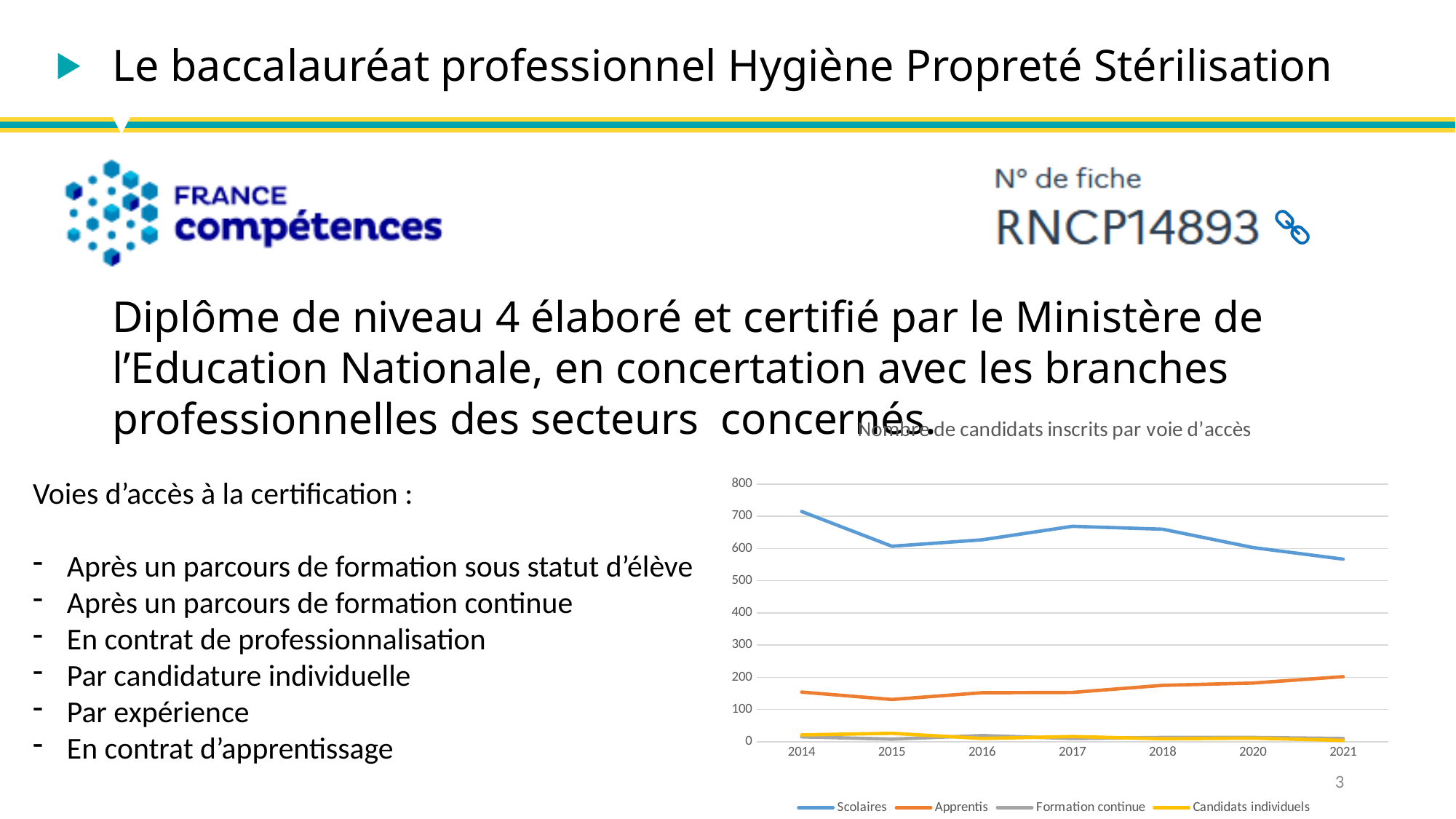
Which series has the highest values across all years in the chart? Scolaires What kind of chart is shown on the slide? line chart What colour is the Apprentis line in the chart? orange Does the Scolaires series rise or fall overall from 2014 to 2021? fall Is the value for Apprentis in 2021 greater or less than 150? greater In which year is the Scolaires series at its highest? 2014 Does the Apprentis series rise or fall overall from 2014 to 2021? rise How many series does the chart legend list? 4 Is the value for Scolaires in 2021 greater or less than 600? less Which is larger in 2017, the value for Scolaires or the value for Apprentis? Scolaires Is the value for Scolaires in 2014 greater or less than 700? greater How many years are plotted along the x axis of the chart? 7